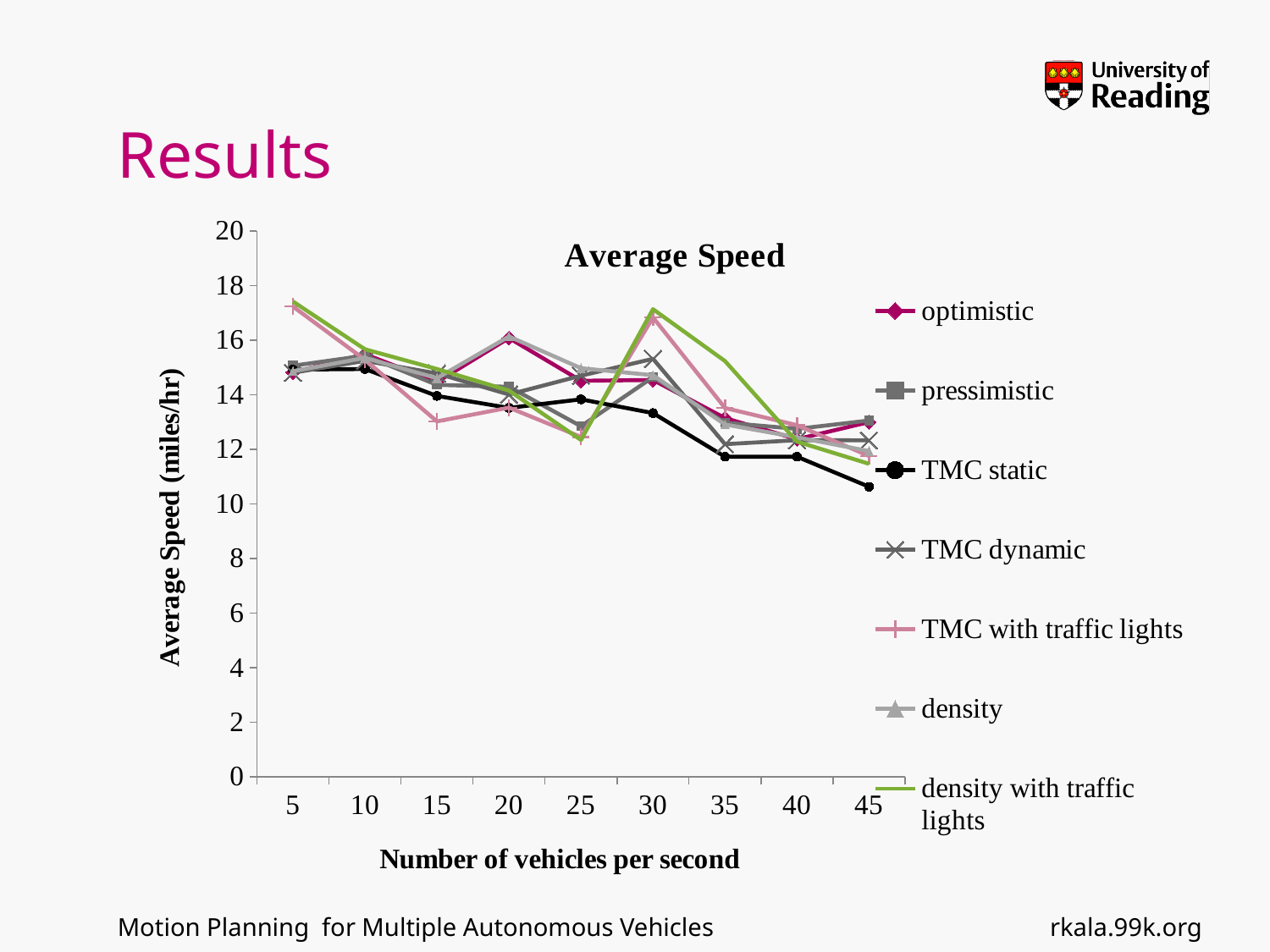
At 45 vehicles per second, which is larger: the value for optimistic or the value for TMC static? optimistic What is the label of the x axis of the chart? Number of vehicles per second What kind of chart is shown on the slide? line chart What is the title of the chart? Average Speed Is the value for TMC static at 45 vehicles per second greater or less than 12? less Does the TMC static series generally rise or fall as the number of vehicles per second increases? fall Is the value for density with traffic lights at 30 vehicles per second greater or less than 16? greater How many series does the legend of the Average Speed chart list? 7 Is the value for TMC with traffic lights at 15 vehicles per second greater or less than 14? less How many points are marked along the x axis of the Average Speed chart? 9 Which series has the lowest value at 45 vehicles per second? TMC static